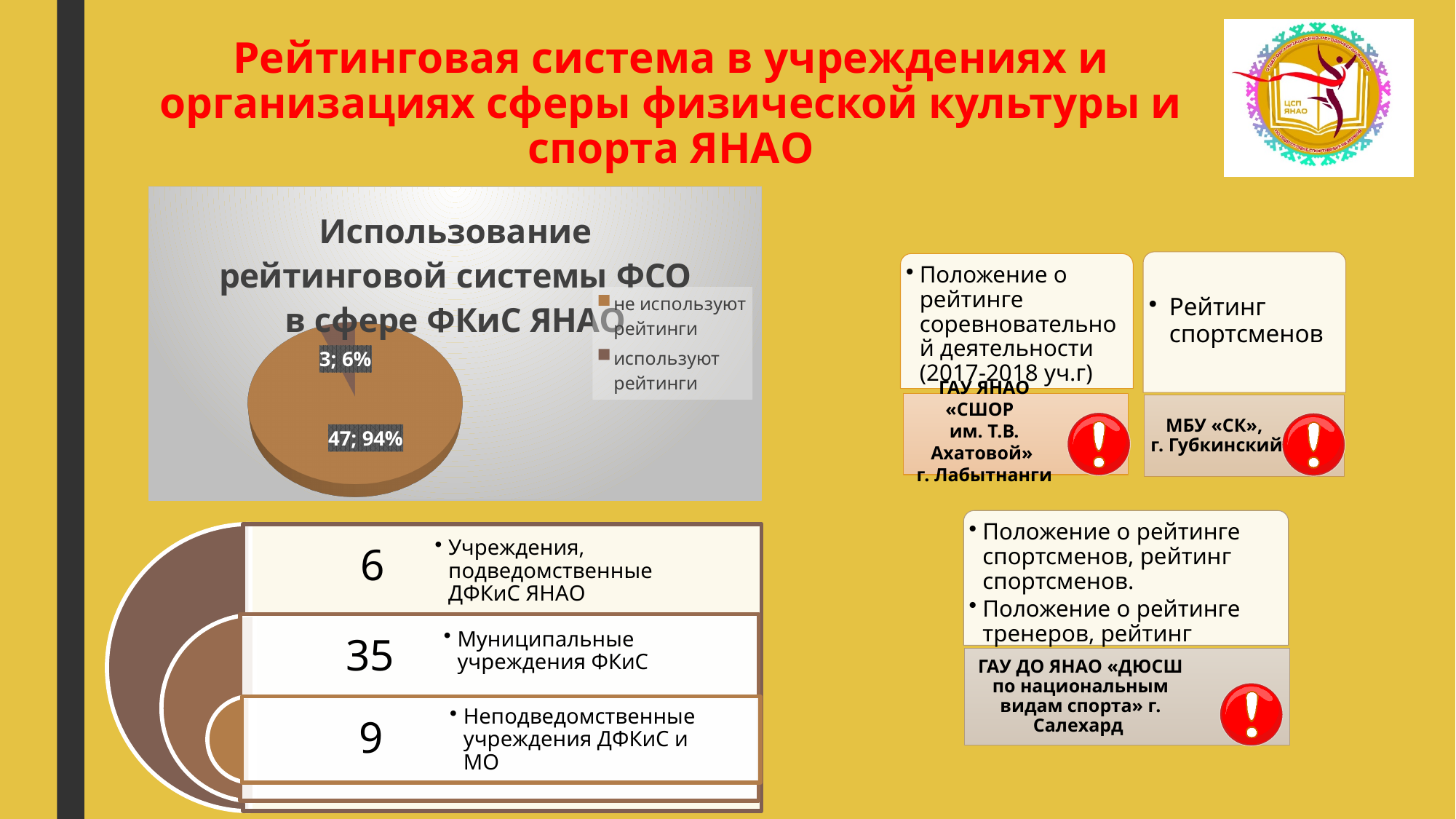
What is the value for "не используют рейтинги" in the pie chart? 47 What is the difference between the values of the two slices in the pie chart? 44 Which slice of the pie chart is the largest? не используют рейтинги What kind of chart is shown on the slide? pie chart What share of the pie does the slice labelled "47" represent? 94% What is the value for "используют рейтинги" in the pie chart? 3 Which slice of the pie chart is the smallest? используют рейтинги How many slices does the pie chart have? 2 What is the total of the two slice values in the pie chart? 50 How many entries does the legend of the pie chart list? 2 What is the title of the pie chart? Использование рейтинговой системы ФСО в сфере ФКиС ЯНАО What share of the pie does the slice labelled "3" represent? 6%